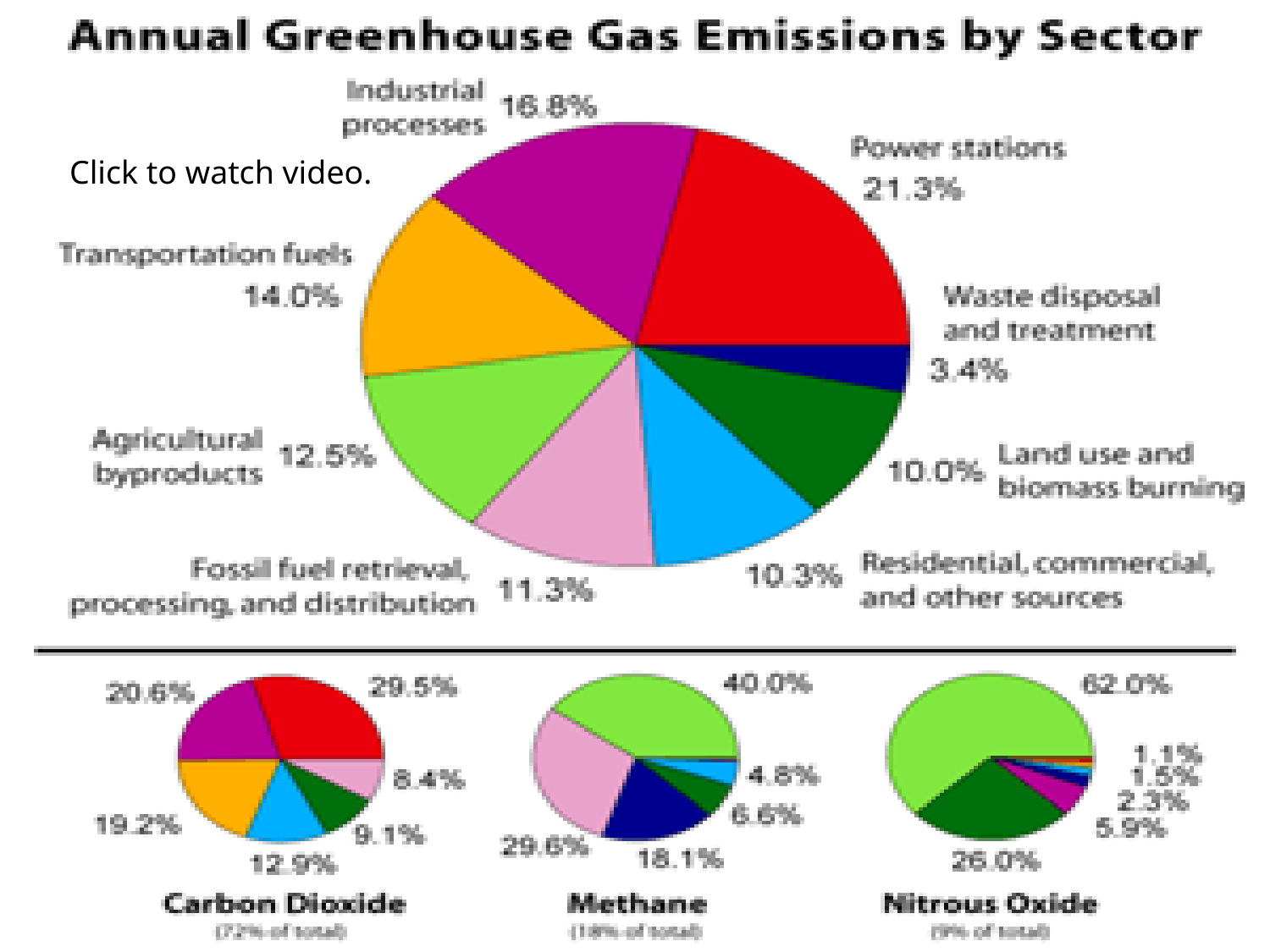
In the Nitrous Oxide pie chart at the bottom, what is the largest slice's percentage? 62.0% In the main pie chart, which sector has the smallest share of emissions? Waste disposal and treatment How many sectors are shown in the main pie chart? 8 In the Methane pie chart at the bottom, what is the largest slice's percentage? 40.0% What type of chart is used to show Annual Greenhouse Gas Emissions by Sector? Pie chart In the main pie chart, which is larger: the share for Agricultural byproducts or the share for Fossil fuel retrieval, processing, and distribution? Agricultural byproducts What is the title of the main chart on the slide? Annual Greenhouse Gas Emissions by Sector In the main pie chart, what is the difference between the shares for Power stations and Industrial processes? 4.5% How many slices does the Methane pie chart at the bottom have? 5 In the main pie chart, which sector has the largest share of emissions? Power stations In the main pie chart, what share of annual greenhouse gas emissions comes from Power stations? 21.3% In the main pie chart, what percentage is attributed to Transportation fuels? 14.0%